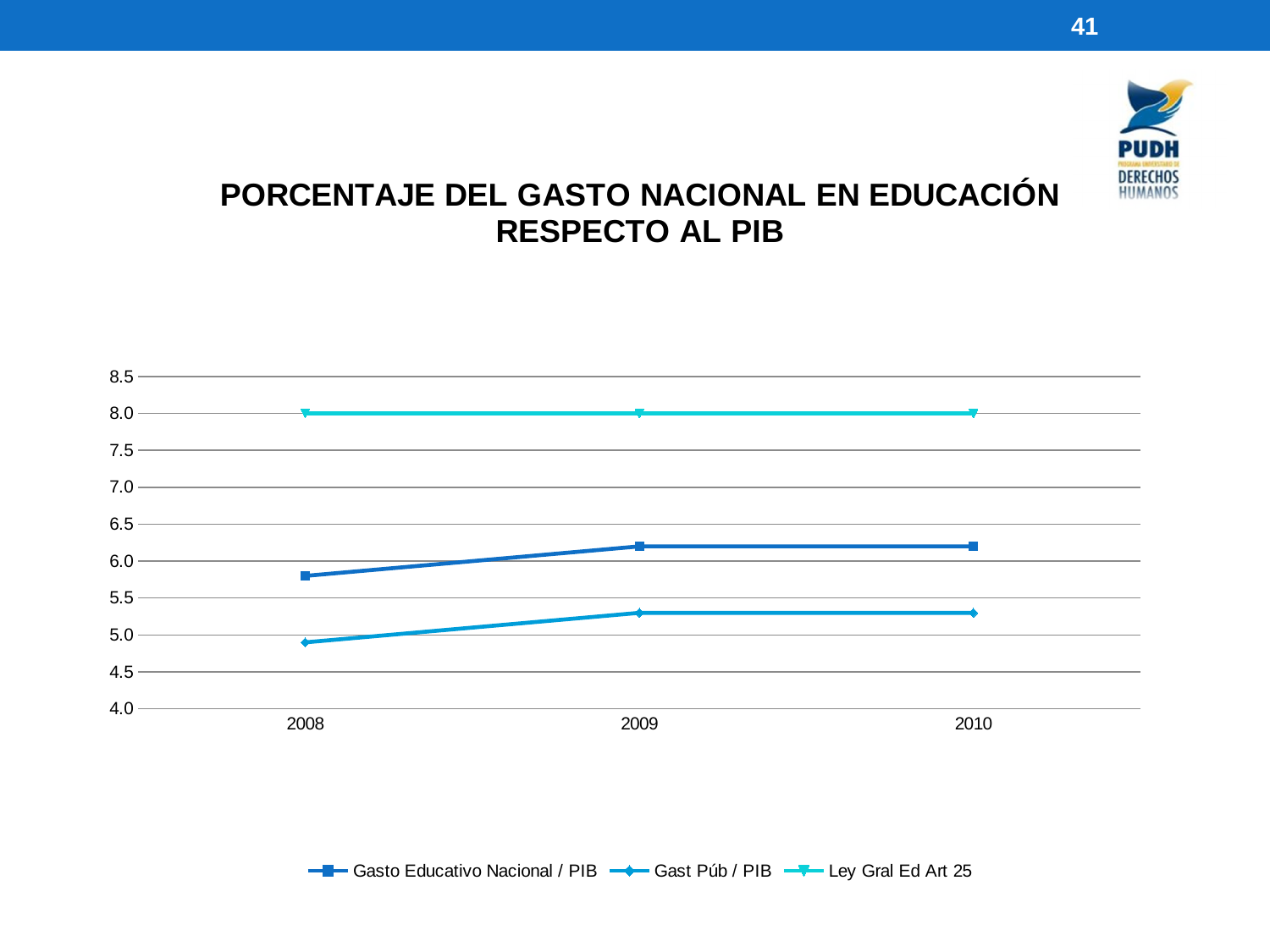
Is the value for Gast Púb / PIB in 2008 greater or less than 5.0? less What is the value of Ley Gral Ed Art 25 in 2010? 8.0 What kind of chart is shown on the slide? Line chart Which series has the lowest values across all years? Gast Púb / PIB What is the value of Ley Gral Ed Art 25 in 2008? 8.0 How many years are shown on the x axis? 3 What is the title of the chart? PORCENTAJE DEL GASTO NACIONAL EN EDUCACIÓN RESPECTO AL PIB Is the value for Gasto Educativo Nacional / PIB in 2008 greater or less than 6.0? less How many series does the legend list? 3 Which series has the highest values across all years? Ley Gral Ed Art 25 Is the value for Gasto Educativo Nacional / PIB in 2009 greater or less than 6.0? greater Does the Gast Púb / PIB series rise or fall from 2008 to 2009? Rise